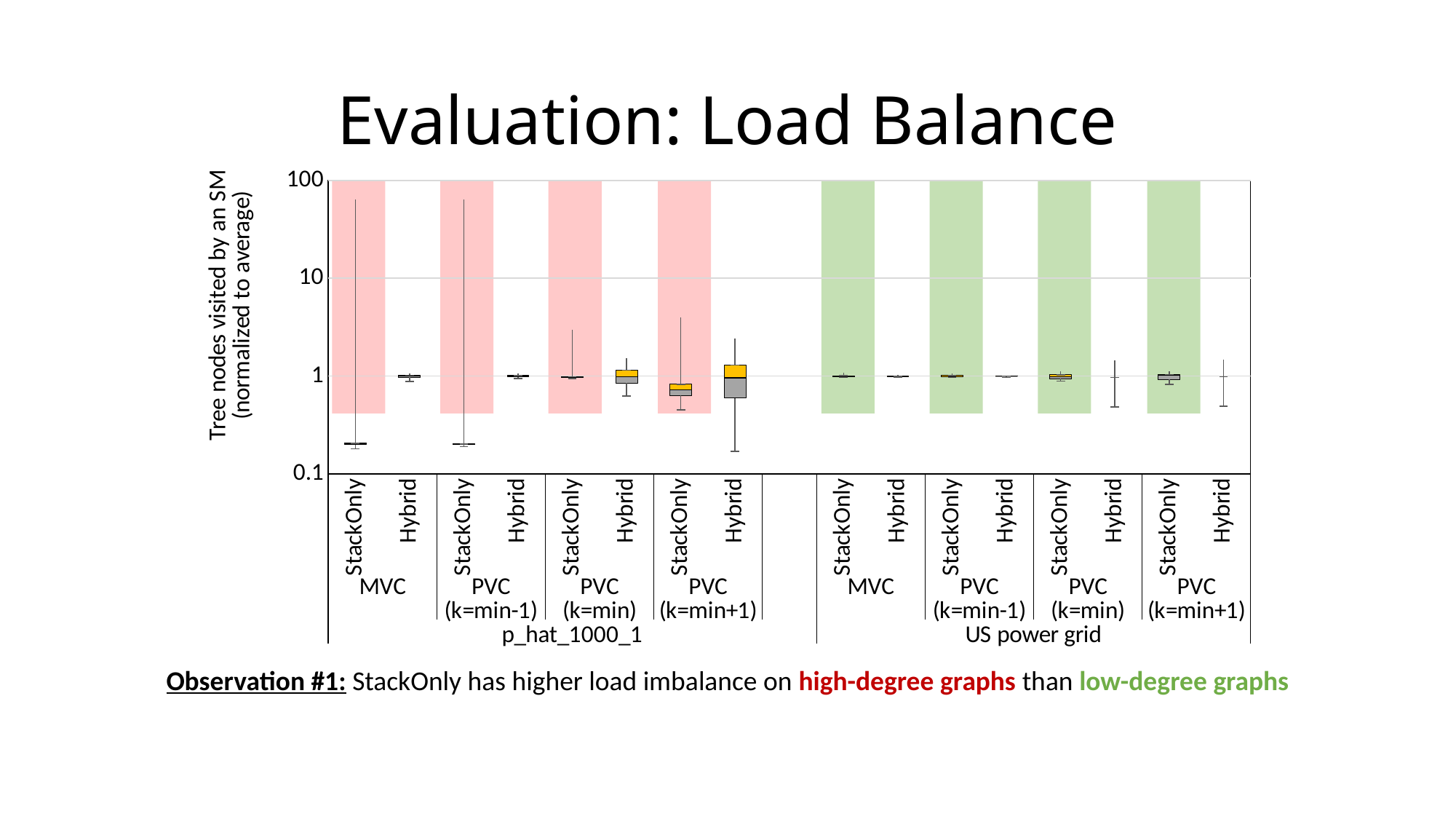
Is the bottom of the lower whisker for StackOnly on MVC for p_hat_1000_1 greater or less than 1? less Which dataset, p_hat_1000_1 or US power grid, has the box plot with the highest upper whisker? p_hat_1000_1 What is the label of the y axis? Tree nodes visited by an SM (normalized to average) What kind of chart is shown on the slide? box plot Is the top of the upper whisker for StackOnly on PVC (k=min-1) for p_hat_1000_1 greater or less than 10? greater How many box plots (StackOnly/Hybrid entries) are shown in total across both datasets? 16 How many problem configurations are shown for the US power grid dataset? 4 Is the bottom of the lower whisker for Hybrid on PVC (k=min+1) for p_hat_1000_1 greater or less than 1? less What is the highest value shown on the y axis? 100 How many datasets (graphs) are compared along the x axis? 2